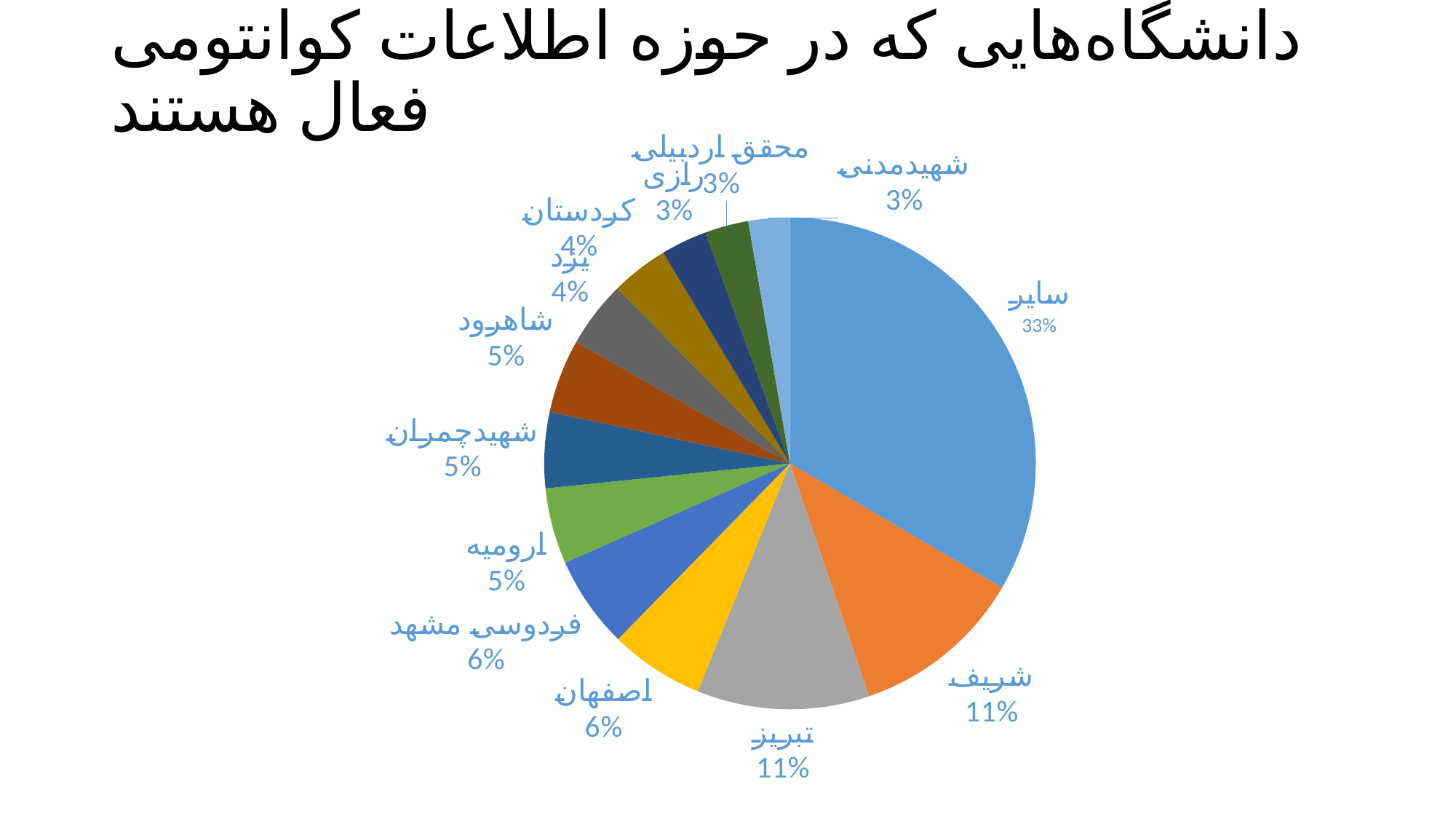
What percentage is shown for شاهرود (Shahrood)? 5% What is the difference in percentage points between سایر (33%) and شریف (11%)? 22 Which slice of the pie is the largest? سایر What share of the pie does the slice labelled سایر (Other) have? 33% What is the title of the slide containing the pie chart? دانشگاه‌هایی که در حوزه اطلاعات کوانتومی فعال هستند What percentage is shown for شریف (Sharif)? 11% How many slices does the pie chart have? 13 What percentage is shown for کردستان (Kurdistan)? 4% What percentage is shown for فردوسی مشهد (Ferdowsi Mashhad)? 6% What kind of chart is shown on the slide? pie chart What percentage is shown for تبریز (Tabriz)? 11% Which is larger, the slice for اصفهان (Isfahan) or the slice for یزد (Yazd)? اصفهان